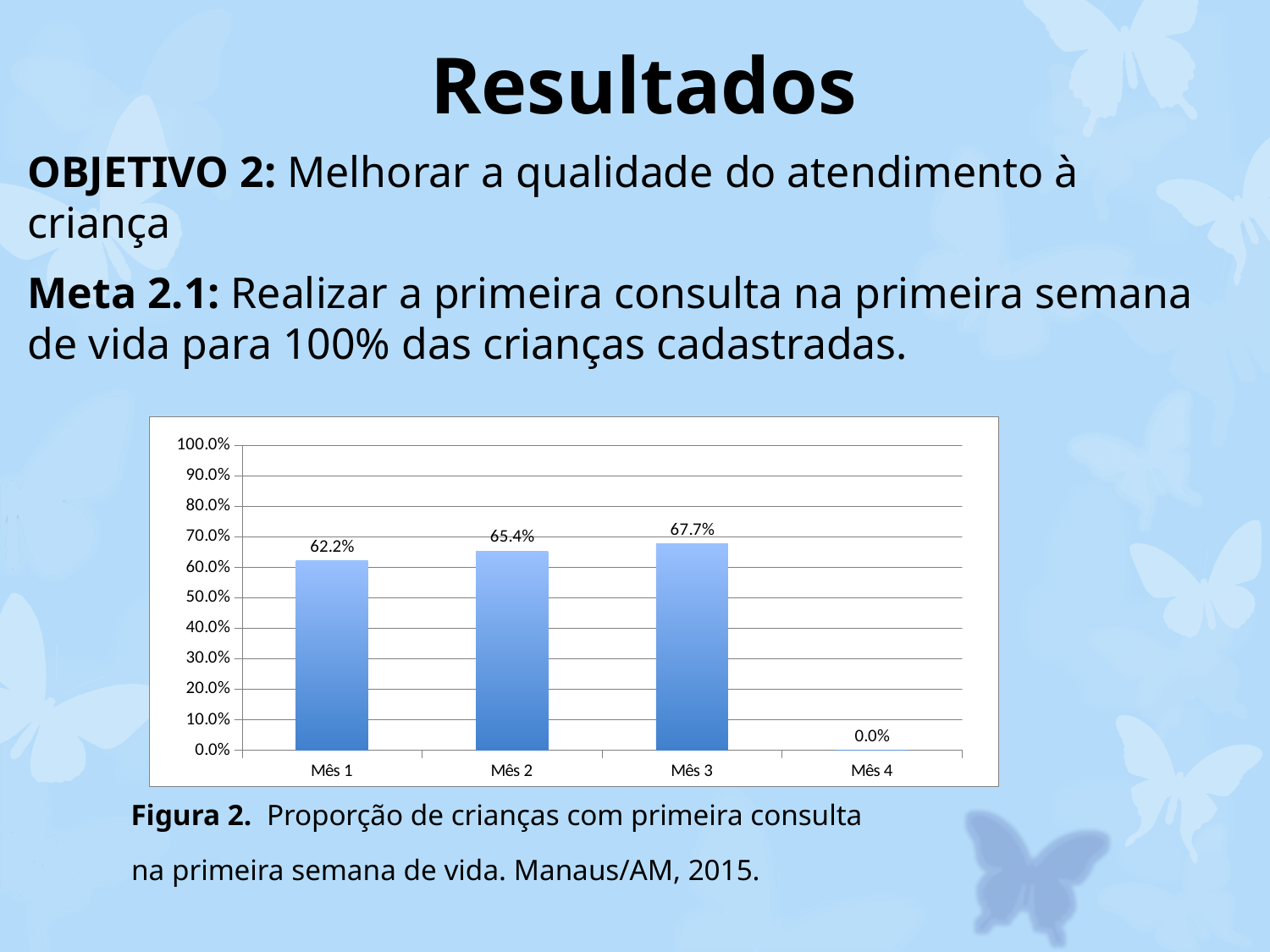
What is the value for Mês 3? 67.7% What is the difference between the values for Mês 3 and Mês 1? 5.5% Is the value for Mês 1 greater or less than 70.0%? less What is the value for Mês 2? 65.4% What is the value for Mês 1? 62.2% Which month has the highest value? Mês 3 What kind of chart is shown on the slide? bar chart What is the value for Mês 4? 0.0% Which is larger, the value for Mês 2 or the value for Mês 3? Mês 3 Which month has the lowest value? Mês 4 How many months are shown on the x axis? 4 What is the difference between the values for Mês 2 and Mês 1? 3.2%